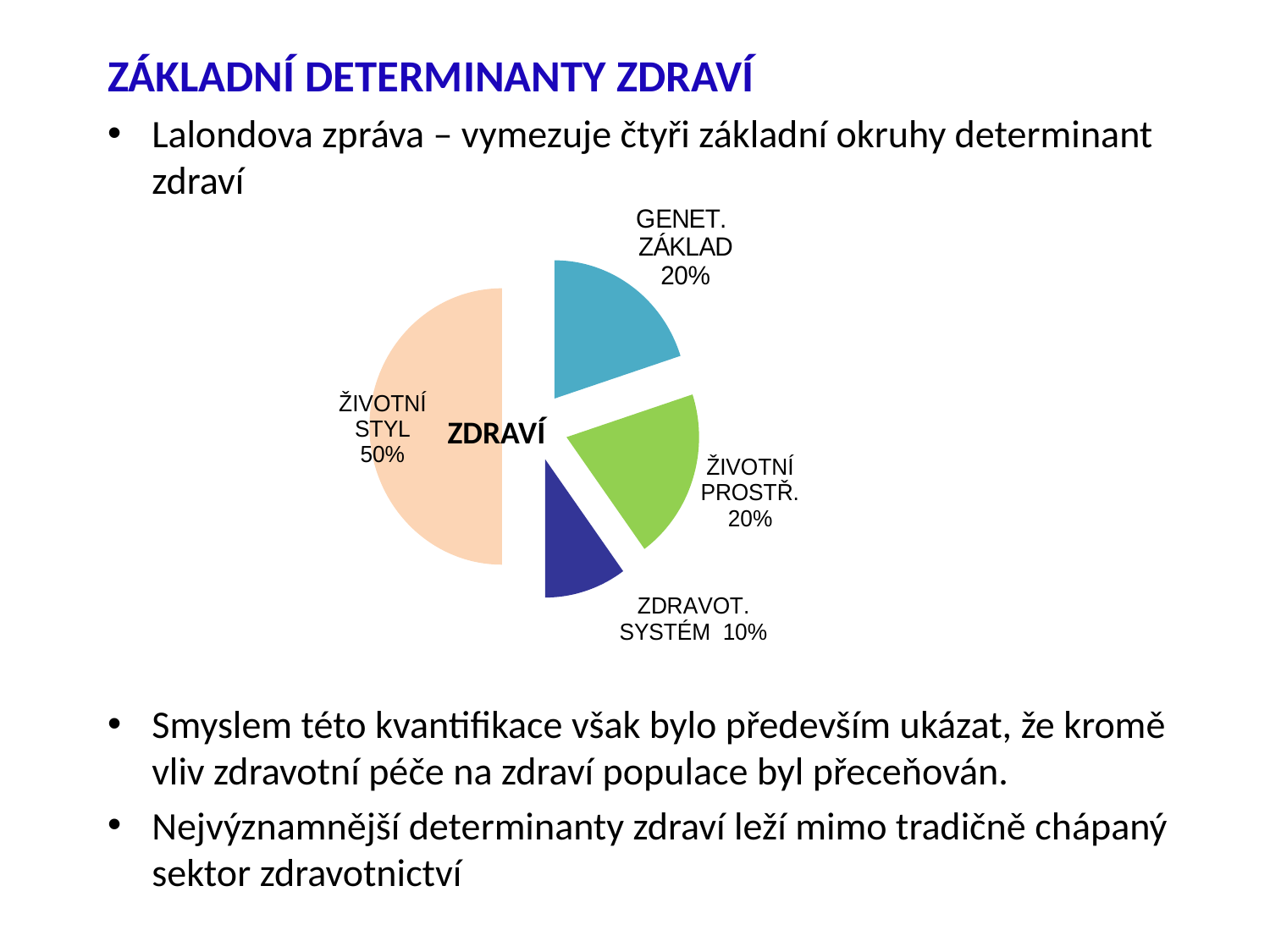
Which is larger, the share of ŽIVOTNÍ PROSTŘ. or the share of ZDRAVOT. SYSTÉM? ŽIVOTNÍ PROSTŘ. What colour is the ŽIVOTNÍ PROSTŘ. slice? green What word is written in the centre of the pie chart? ZDRAVÍ What kind of chart is shown on the slide? pie chart What share of the pie does ŽIVOTNÍ PROSTŘ. have? 20% Which slice of the pie is the smallest? ZDRAVOT. SYSTÉM What share of the pie does ŽIVOTNÍ STYL have? 50% What share of the pie does GENET. ZÁKLAD have? 20% Which slice of the pie is the largest? ŽIVOTNÍ STYL How many slices does the pie chart have? 4 What is the difference between the shares of ŽIVOTNÍ STYL and ZDRAVOT. SYSTÉM? 40%